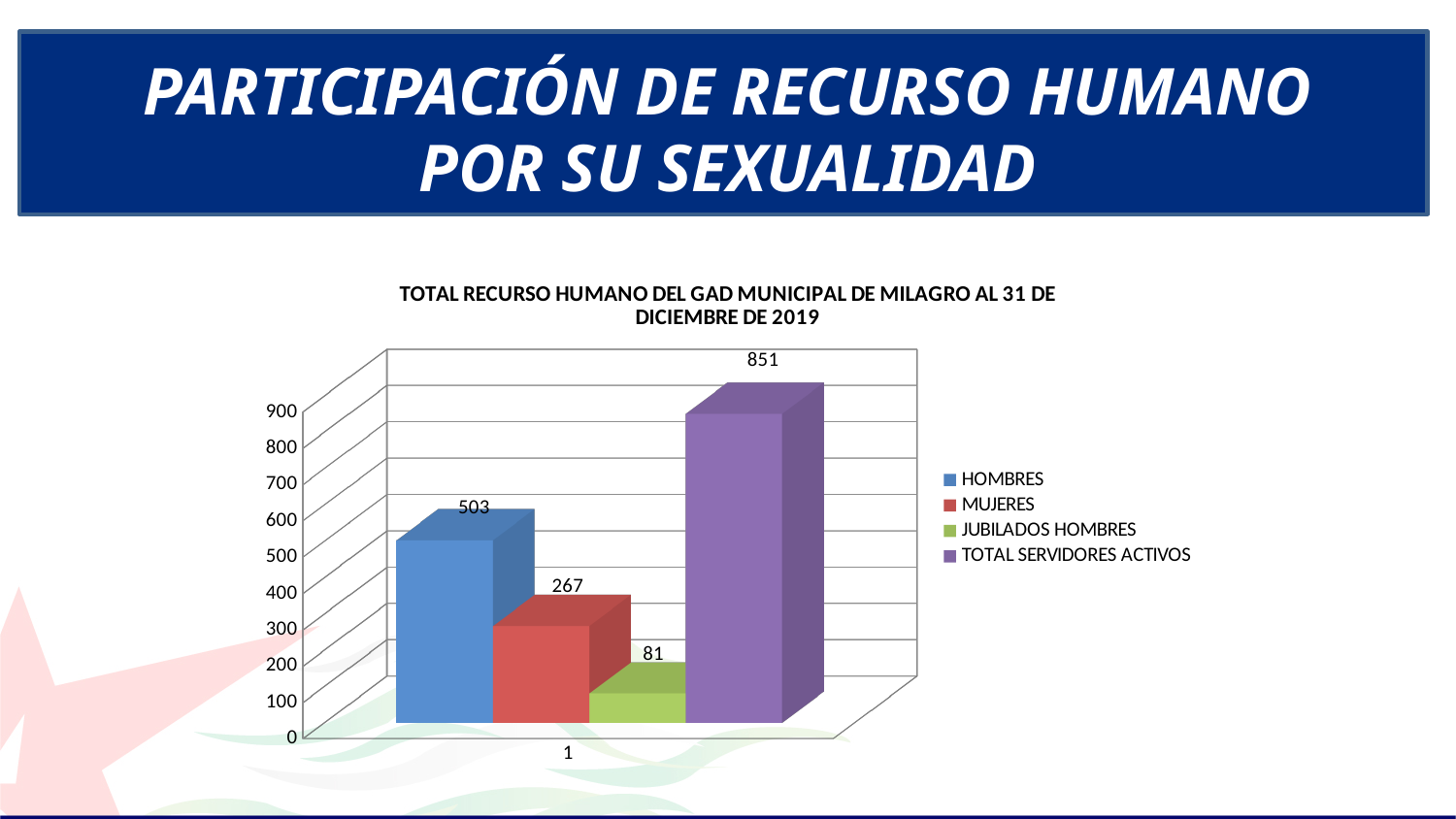
What is the value for TOTAL SERVIDORES ACTIVOS? 851 What is the value for JUBILADOS HOMBRES? 81 What is the difference between the values for HOMBRES and MUJERES? 236 Which series has the highest value? TOTAL SERVIDORES ACTIVOS Which series has the lowest value? JUBILADOS HOMBRES What is the value for MUJERES? 267 What is the title of the chart? TOTAL RECURSO HUMANO DEL GAD MUNICIPAL DE MILAGRO AL 31 DE DICIEMBRE DE 2019 What kind of chart is shown on the slide? bar chart What is the difference between the values for TOTAL SERVIDORES ACTIVOS and HOMBRES? 348 How many series does the legend list? 4 What is the value for HOMBRES? 503 Which is larger, the value for MUJERES or the value for JUBILADOS HOMBRES? MUJERES